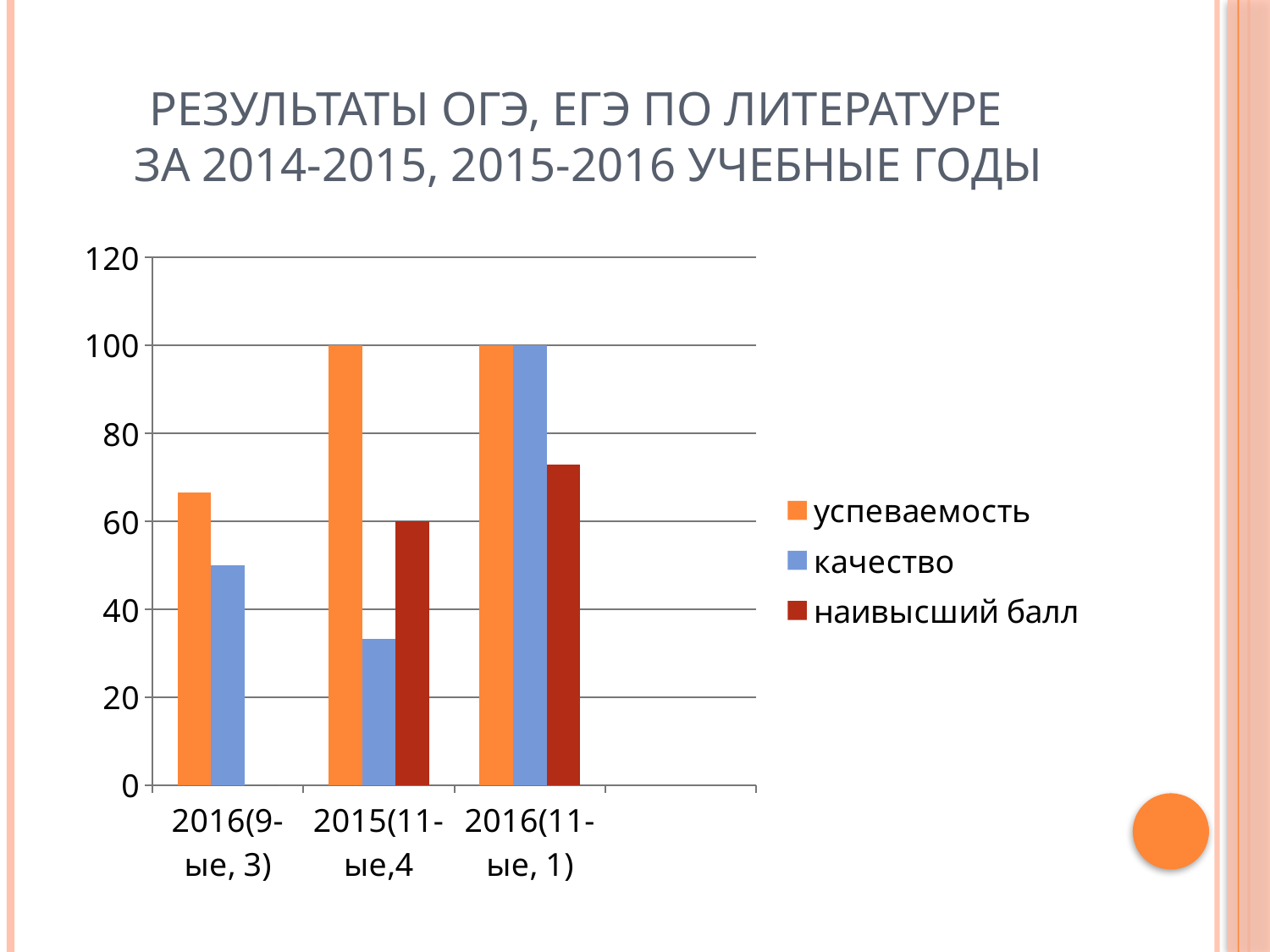
What kind of chart is shown on the slide? bar chart How many series does the legend list? 3 Which category has the lowest value of качество? 2015(11-ые,4 Is the value of наивысший балл for 2016(11-ые, 1) greater or less than 80? less How many categories are shown on the x axis? 3 What is the difference between успеваемость and наивысший балл for 2015(11-ые,4)? 40 What is the value of успеваемость for 2015(11-ые,4)? 100 Is the value of успеваемость for 2016(9-ые, 3) greater or less than 60? greater What is the value of наивысший балл for 2015(11-ые,4)? 60 Which is larger: наивысший балл for 2015(11-ые,4) or for 2016(11-ые, 1)? 2016(11-ые, 1) What is the value of качество for 2016(11-ые, 1)? 100 Is the value of качество for 2015(11-ые,4) greater or less than 40? less